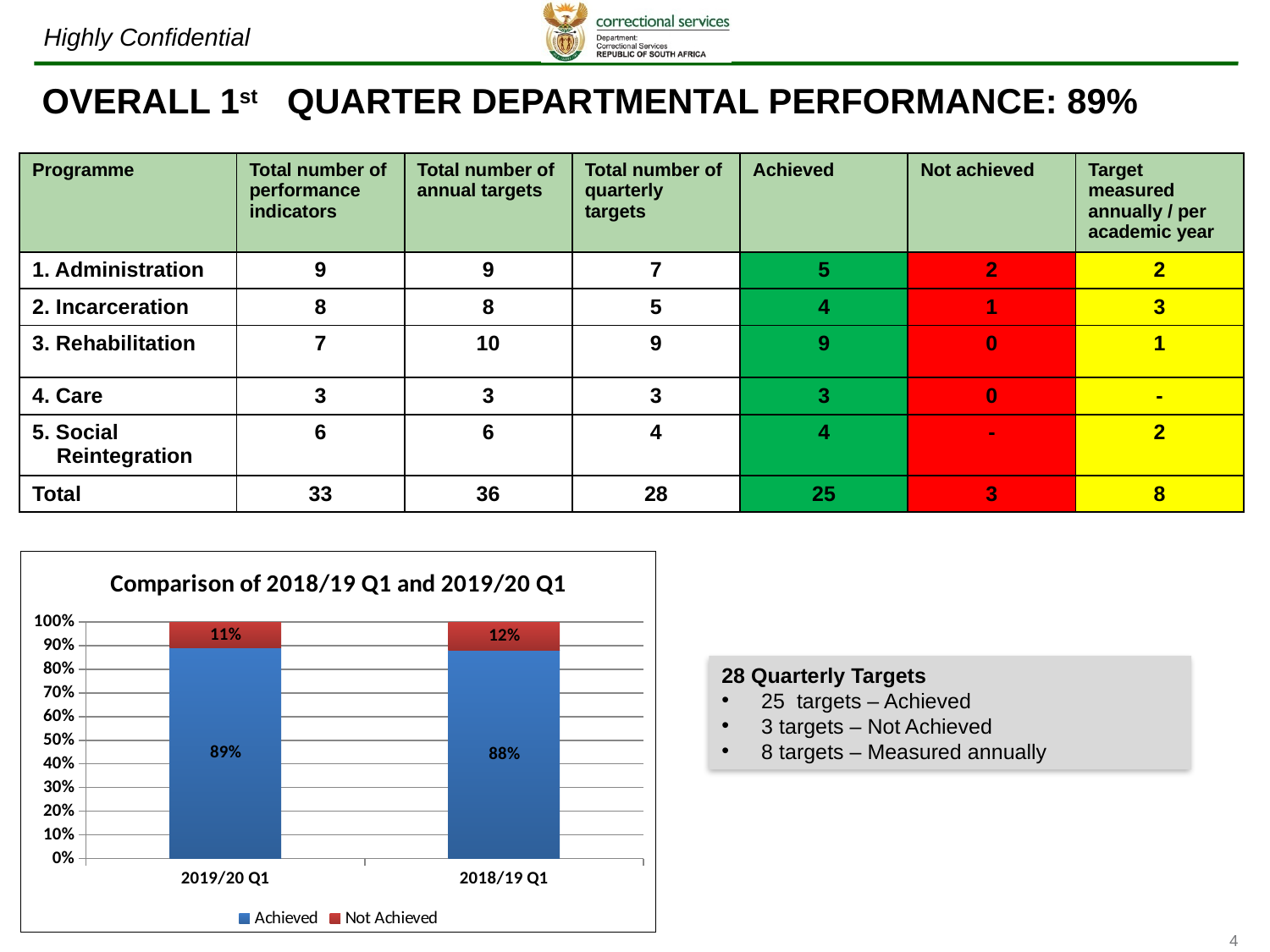
What is the Not Achieved value for 2018/19 Q1 in the chart? 12% Is the Achieved value for 2018/19 Q1 larger or smaller than the Achieved value for 2019/20 Q1? smaller Which quarter has the higher Achieved percentage in the chart? 2019/20 Q1 How many series does the chart legend list? 2 What is the Achieved value for 2019/20 Q1 in the chart? 89% How many categories are shown on the x axis of the chart? 2 What is the difference between the Achieved values for 2019/20 Q1 and 2018/19 Q1? 1% What kind of chart is shown on the slide? stacked bar chart Which quarter has the lower Not Achieved percentage in the chart? 2019/20 Q1 What is the Achieved value for 2018/19 Q1 in the chart? 88% What is the Not Achieved value for 2019/20 Q1 in the chart? 11% What is the title of the chart? Comparison of 2018/19 Q1 and 2019/20 Q1